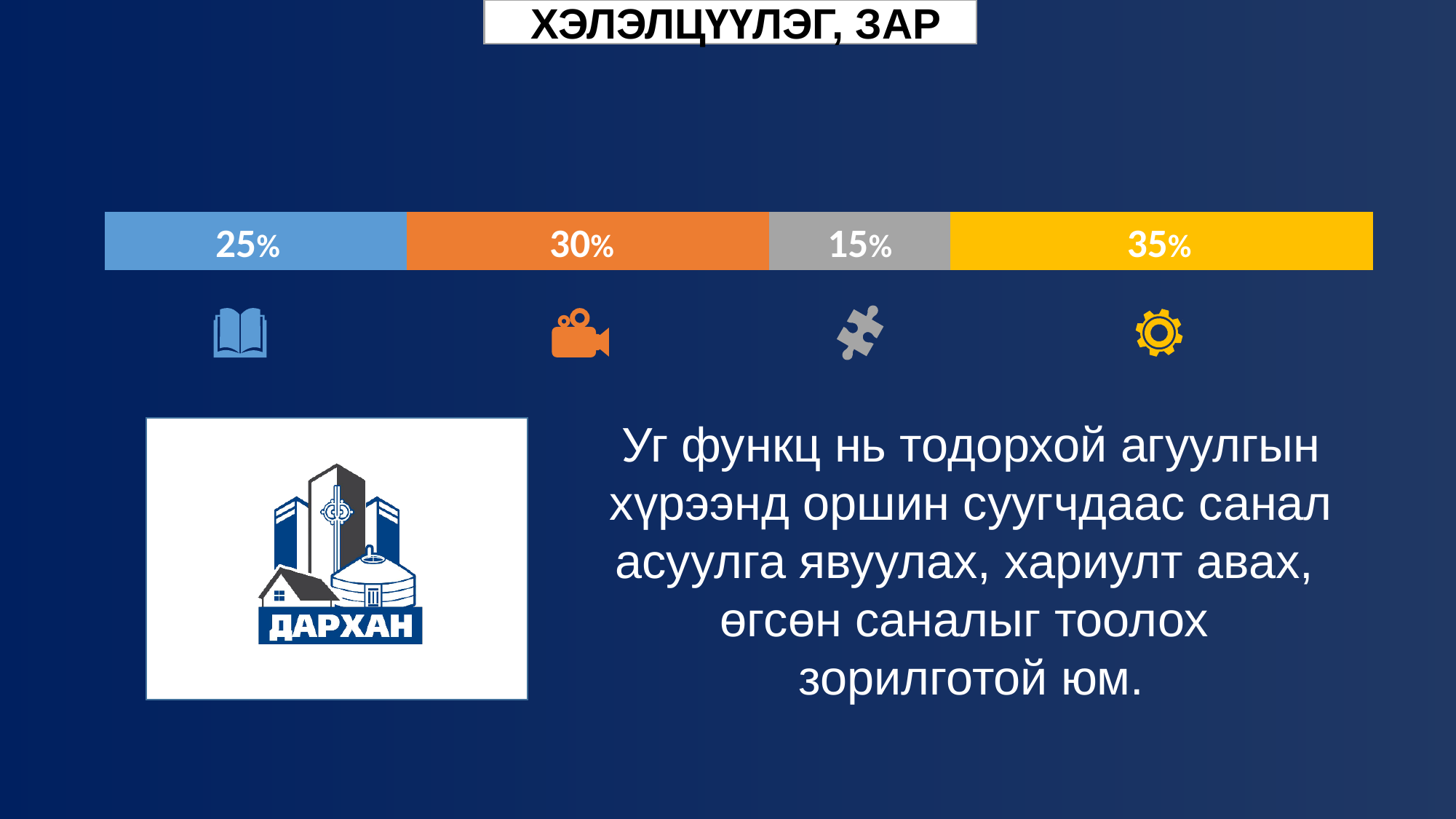
What kind of chart is shown on the slide? A horizontal stacked bar chart What value is shown on the yellow segment of the stacked bar? 35% Which is larger, the orange segment or the gray segment of the bar? The orange segment Which segment of the stacked bar has the lowest value? The gray segment (15%) What is the total of all segments in the stacked bar? 105% Which segment of the stacked bar has the highest value? The yellow segment (35%) How many segments does the stacked bar contain? 4 What is the title shown at the top of the slide above the chart? ХЭЛЭЛЦҮҮЛЭГ, ЗАР What is the difference between the yellow segment and the blue segment of the bar? 10% What value is shown on the blue segment of the stacked bar? 25% What value is shown on the orange segment of the stacked bar? 30% What value is shown on the gray segment of the stacked bar? 15%